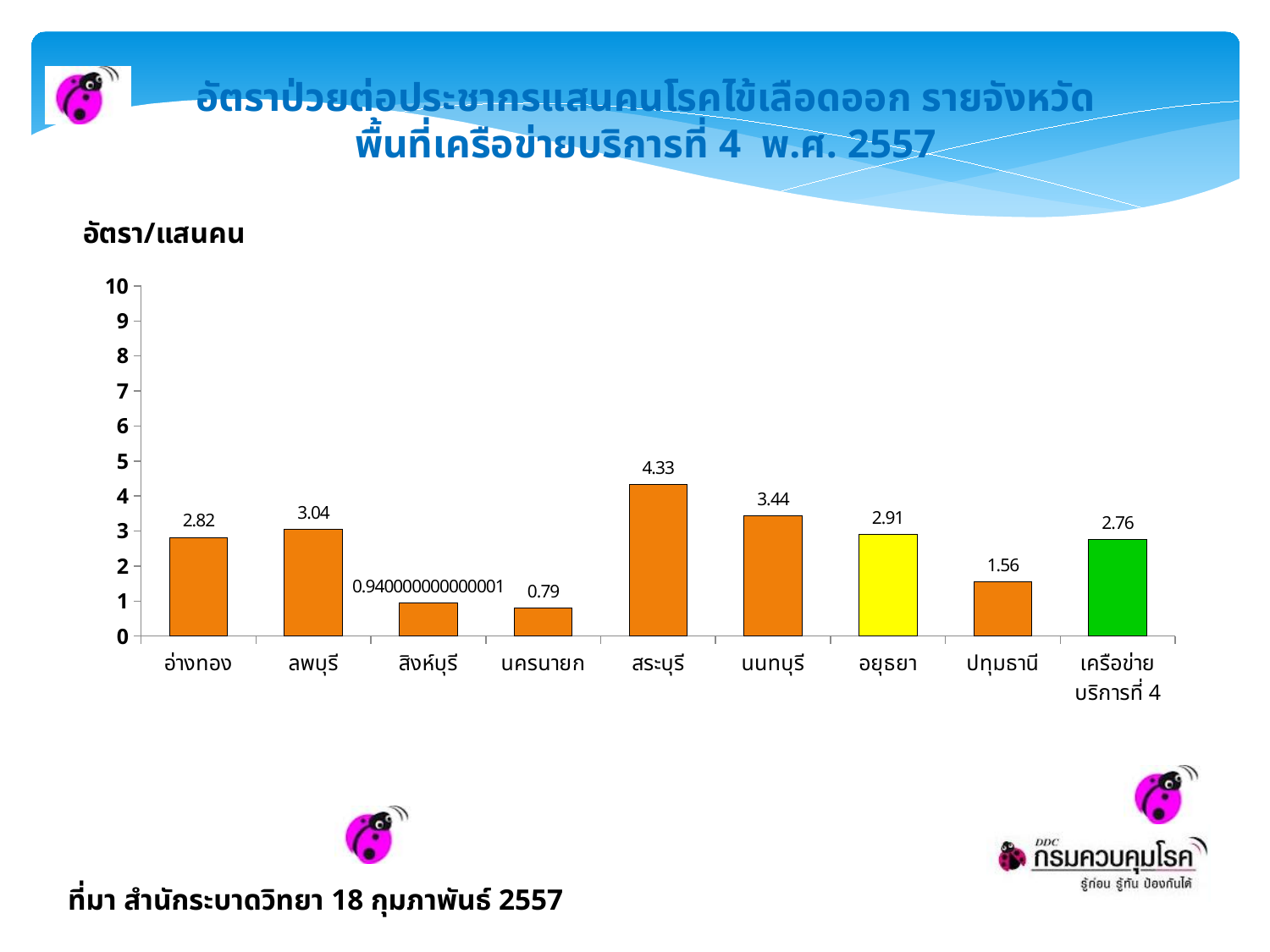
Which category has the lowest value? นครนายก What colour is the bar for อยุธยา? yellow How many categories are shown on the x axis? 9 What is the value for เครือข่ายบริการที่ 4? 2.76 What is the value for นครนายก? 0.79 Which is larger, the value for ลพบุรี or the value for อยุธยา? ลพบุรี What kind of chart is shown on the slide? bar chart Is the value for นนทบุรี greater or less than 3? greater What is the value for ปทุมธานี? 1.56 What is the value for สระบุรี? 4.33 Which province has the highest value? สระบุรี What is the difference between the values for สระบุรี and นนทบุรี? 0.89